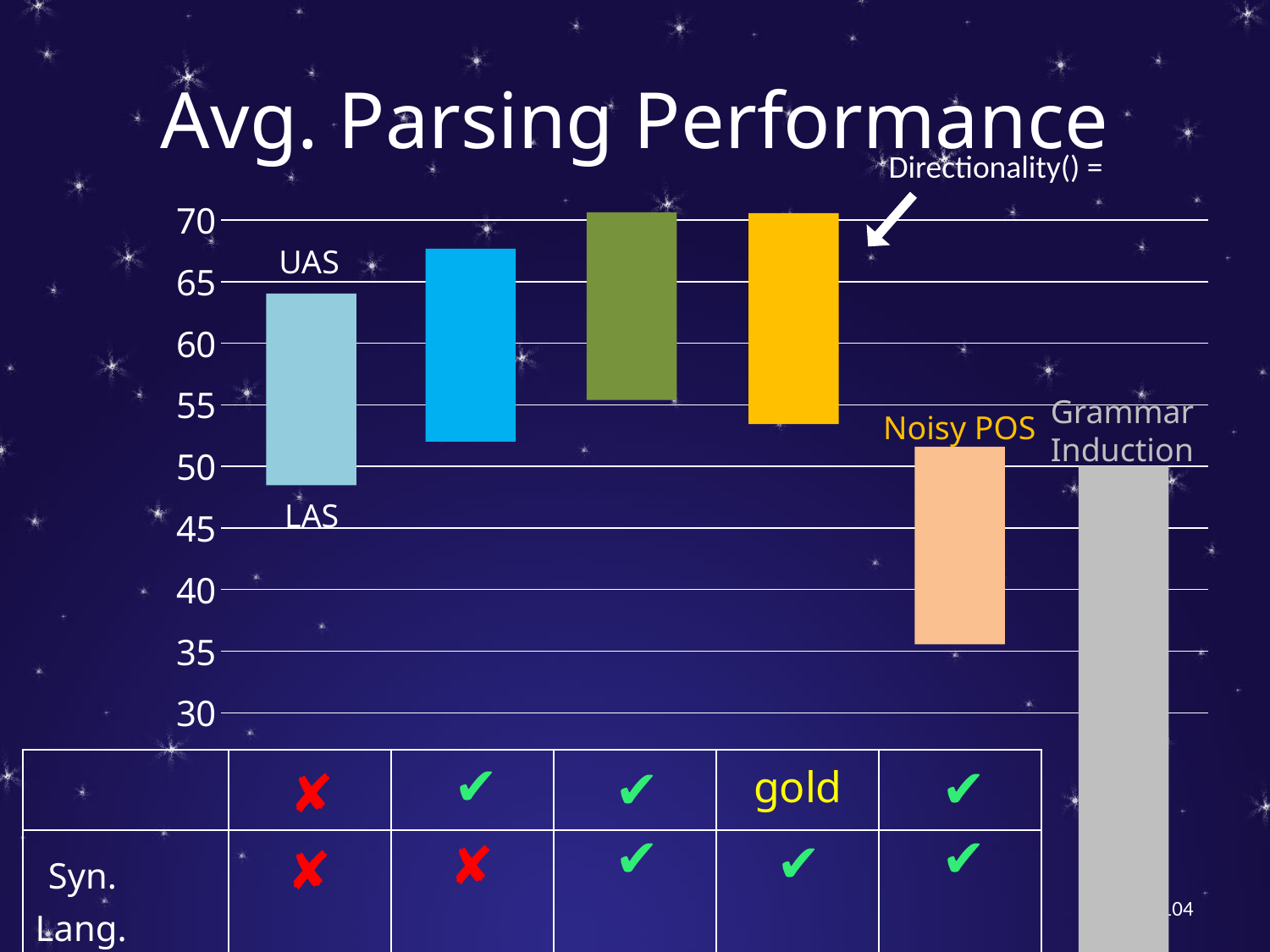
Which two metrics mark the top and bottom of each bar, according to the labels on the chart? UAS (top) and LAS (bottom) Is the top of the Noisy POS bar greater or less than 55? less Is the bottom of the Noisy POS bar greater or less than 40? less Which bar reaches higher at its top: the Noisy POS bar or the Grammar Induction bar? Noisy POS Is the top of the leftmost (light blue) bar greater or less than 60? greater What is the title of the chart? Avg. Parsing Performance Which bar reaches higher at its top: the leftmost (light blue) bar or the Noisy POS bar? the leftmost (light blue) bar How many bars are plotted in the chart? 6 What kind of chart is shown on the slide? bar chart